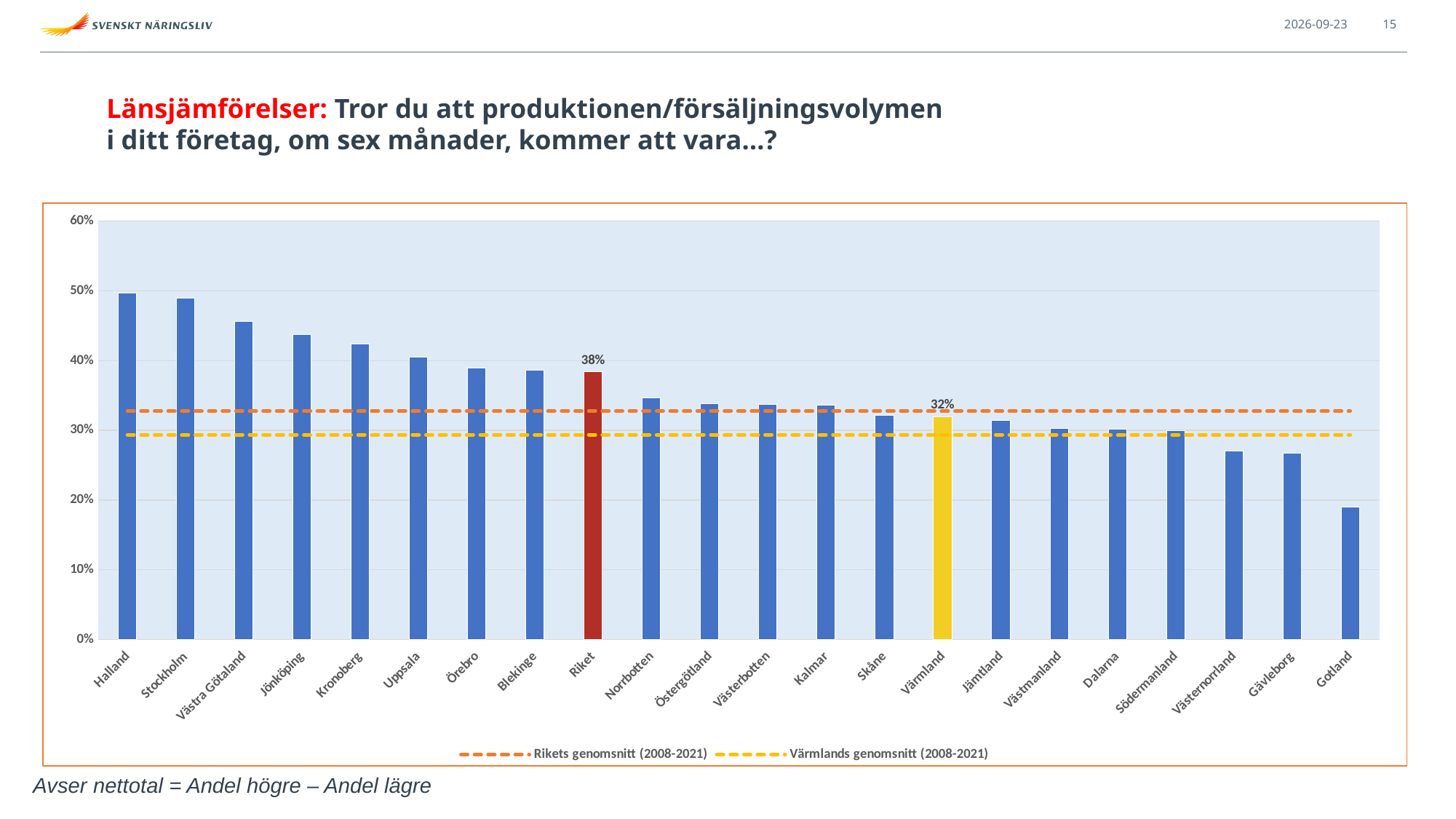
Which county has the lowest value? Gotland How many bars are shown in the chart? 22 Is the value for Halland greater or less than 40%? greater What is the value for Värmland? 32% What is the difference between the values for Riket and Värmland? 6 percentage points Is the value for Gävleborg greater or less than 30%? less What is the value for Riket? 38% How many entries does the legend list? 2 What kind of chart is shown on the slide? bar chart Do the bar values rise or fall from left to right along the x axis? fall Which is larger, the value for Riket or the value for Värmland? Riket Is the value for Kronoberg greater or less than 40%? greater